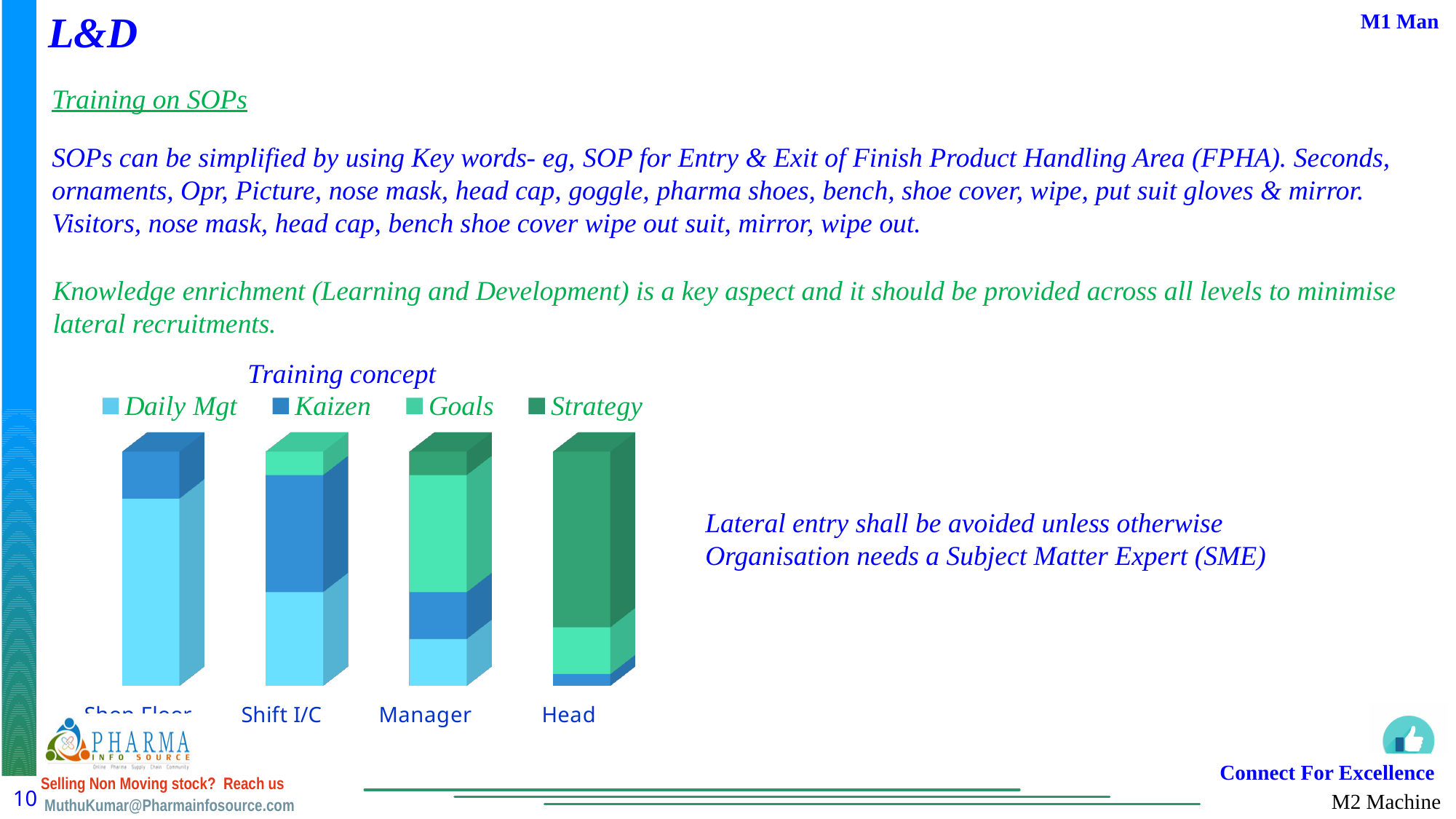
In the 'Training concept' chart, which category has the largest Goals segment? Manager What is the title of the chart on the slide? Training concept How many series does the legend of the 'Training concept' chart list? 4 What kind of chart is the 'Training concept' chart? stacked bar chart Which series is not present in the Head bar of the 'Training concept' chart? Daily Mgt In the 'Training concept' chart, is the Goals segment larger for Manager or for Shift I/C? Manager In the 'Training concept' chart, is the Daily Mgt segment larger for Shift I/C or for Manager? Shift I/C In the 'Training concept' chart, which category has the largest Strategy segment? Head In the 'Training concept' chart, is the Kaizen segment larger for Shift I/C or for Head? Shift I/C In the 'Training concept' chart, which category has the largest Kaizen segment? Shift I/C In the 'Training concept' chart, does the Strategy segment rise or fall moving from Shift I/C to Head? rise How many categories (bars) are shown in the 'Training concept' chart? 4